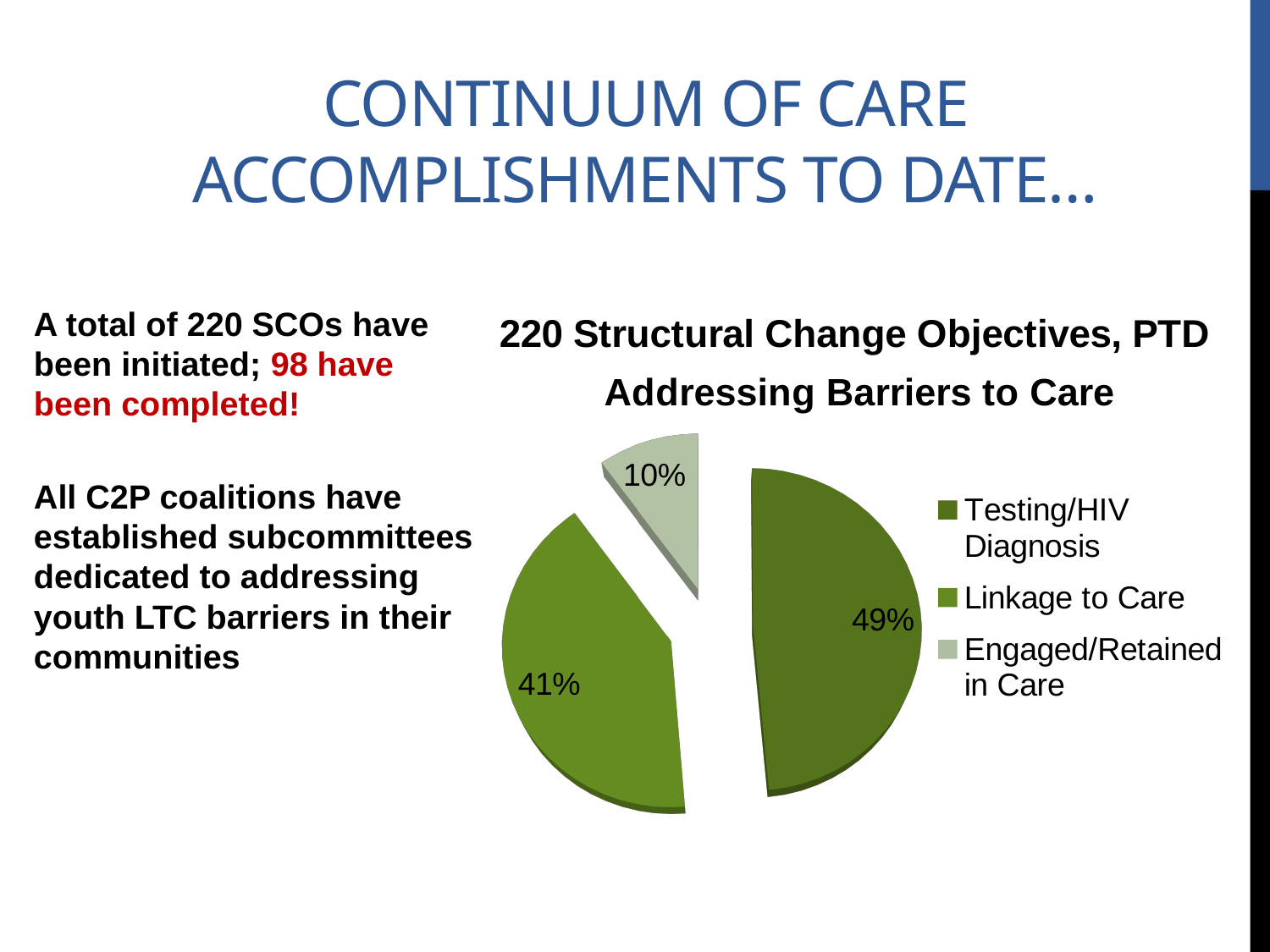
What share of the pie does Linkage to Care represent? 41% What is the difference in percentage points between Testing/HIV Diagnosis and Linkage to Care? 8 Which category has the smallest slice of the pie? Engaged/Retained in Care What is the difference in percentage points between Linkage to Care and Engaged/Retained in Care? 31 Which category is shown in the lightest colour in the legend? Engaged/Retained in Care What share of the pie does Testing/HIV Diagnosis represent? 49% What kind of chart is shown on the slide? pie chart How many categories does the pie chart show? 3 What is the title of the pie chart? 220 Structural Change Objectives, PTD Addressing Barriers to Care Which is larger, the slice for Linkage to Care or the slice for Engaged/Retained in Care? Linkage to Care What share of the pie does Engaged/Retained in Care represent? 10% Which category has the largest slice of the pie? Testing/HIV Diagnosis